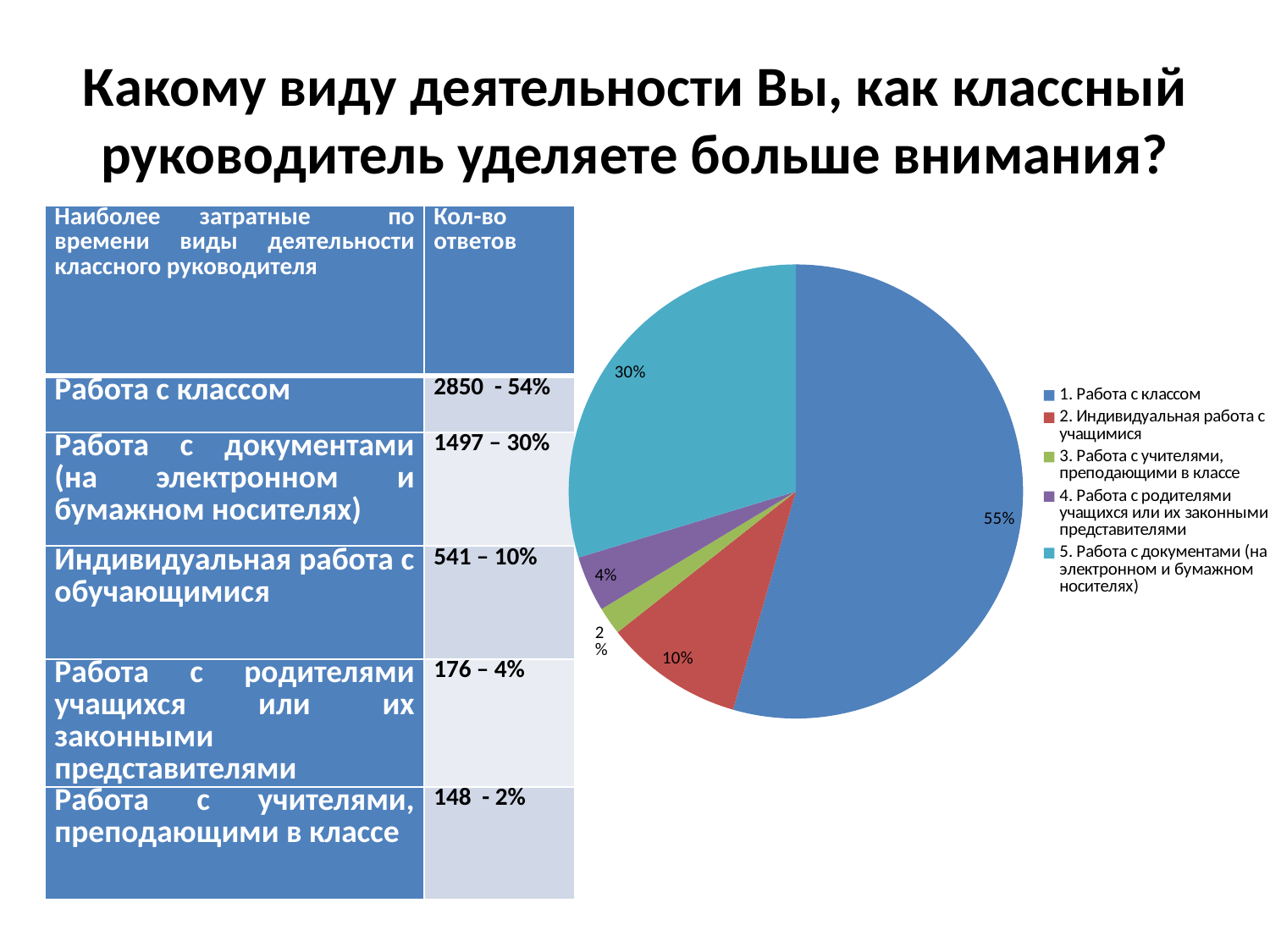
What share of the pie does "3. Работа с учителями, преподающими в классе" have? 2% How many slices does the pie chart have? 5 Which category has the largest slice of the pie chart? 1. Работа с классом How many entries does the legend of the pie chart list? 5 What share of the pie does "5. Работа с документами (на электронном и бумажном носителях)" have? 30% What share of the pie does "2. Индивидуальная работа с учащимися" have? 10% What is the difference in percentage points between the slices for "1. Работа с классом" and "5. Работа с документами (на электронном и бумажном носителях)"? 25 Which slice is larger: "2. Индивидуальная работа с учащимися" or "4. Работа с родителями учащихся или их законными представителями"? 2. Индивидуальная работа с учащимися What kind of chart is shown on the slide? pie chart Which category has the smallest slice of the pie chart? 3. Работа с учителями, преподающими в классе